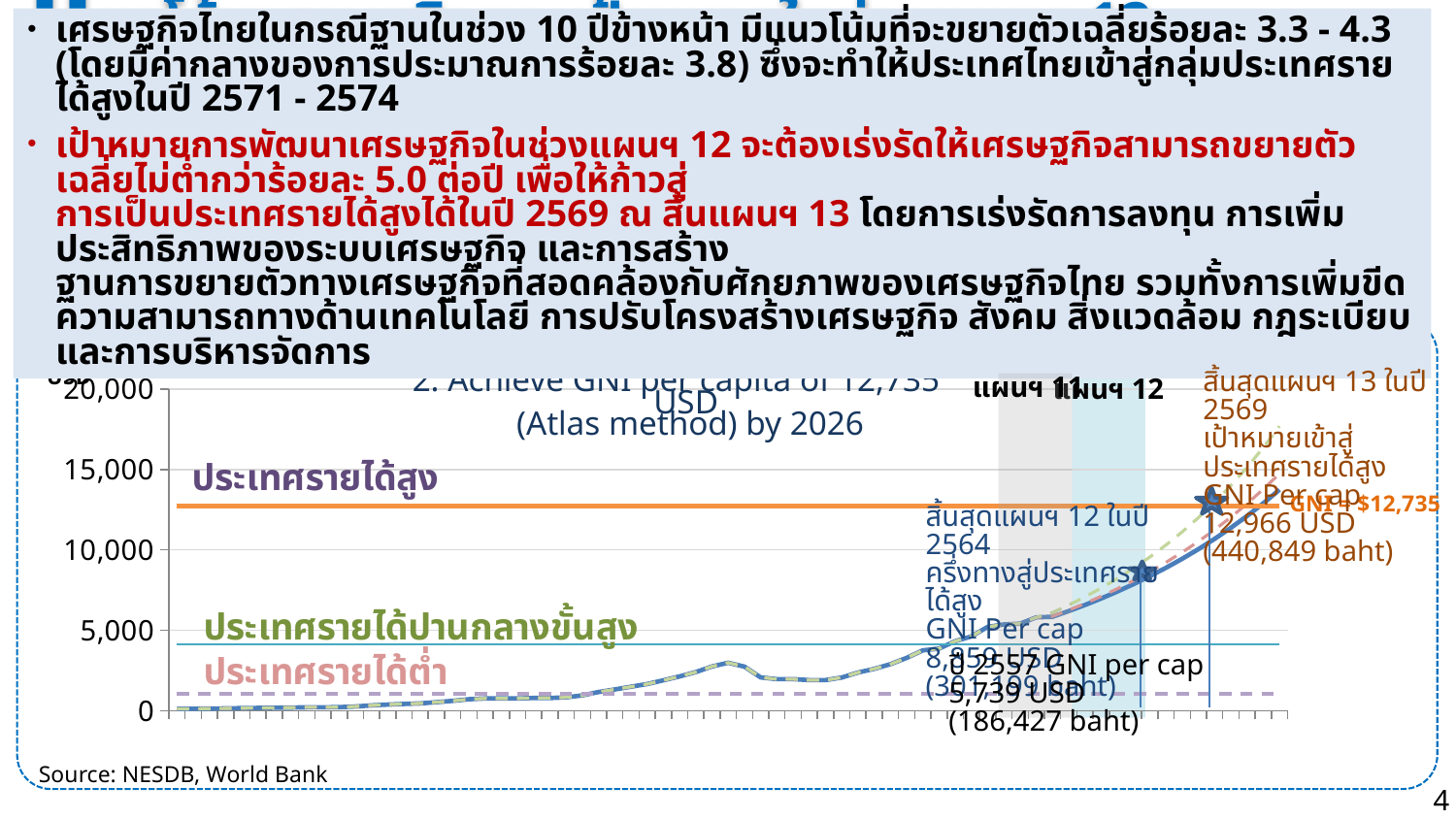
What is the difference in USD between the GNI per capita at the end of Plan 13 (2569) and at the end of Plan 12 (2564)? 4,107 USD What source is cited for the chart? NESDB, World Bank What is the difference in USD between the GNI per capita at the end of Plan 12 (2564) and in 2557? 3,120 USD What kind of chart is shown on the slide? line chart According to the chart annotation, what is GNI per capita in USD at the end of Plan 12 in 2564? 8,859 USD What is the GNI per capita in baht at the end of Plan 13 in 2569, as annotated on the chart? 440,849 baht What GNI per capita value in USD is labelled on the orange high-income threshold line? $12,735 According to the chart annotation, what is the GNI per capita target in USD at the end of Plan 13 in 2569? 12,966 USD Does the GNI per capita line generally rise or fall from left to right along the x axis? rise According to the chart annotation, what was GNI per capita in USD in 2557? 5,739 USD Which is larger: the GNI per capita in 2557 or at the end of Plan 12 in 2564? end of Plan 12 in 2564 Is the high-income threshold line (ประเทศรายได้สูง) greater or less than 10,000 on the y axis? greater